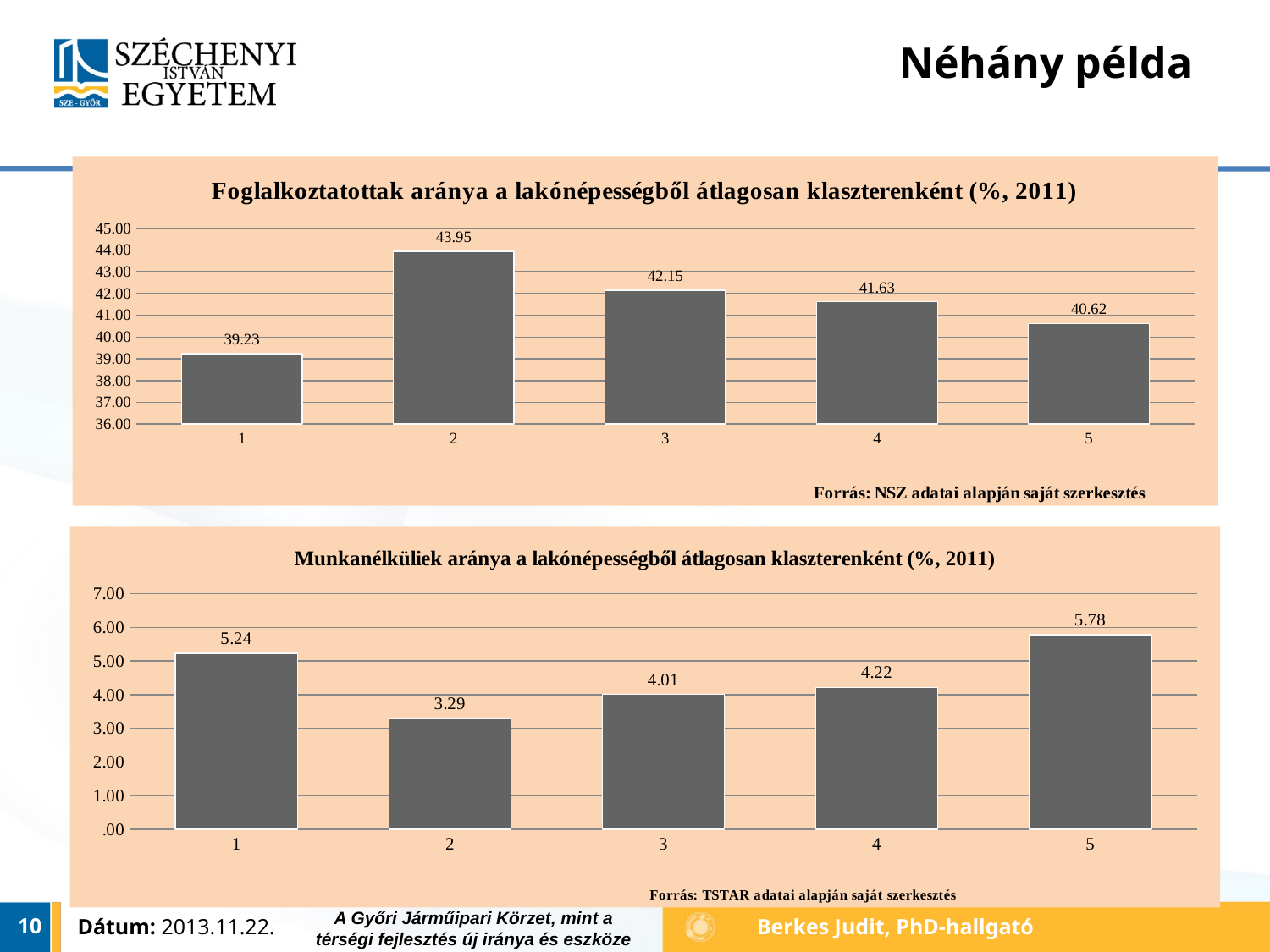
In the top chart (Foglalkoztatottak aránya), which is larger, the value for cluster 3 or cluster 4? cluster 3 In the bottom chart (Munkanélküliek aránya), what is the difference between the values for cluster 1 and cluster 2? 1.95 In the top chart (Foglalkoztatottak aránya), how many clusters are plotted? 5 In the top chart (Foglalkoztatottak aránya), which cluster has the lowest value? 1 In the bottom chart (Munkanélküliek aránya), what is the value for cluster 5? 5.78 In the top chart (Foglalkoztatottak aránya), is the value for cluster 5 greater or less than 40.00? greater What type of chart is the bottom chart (Munkanélküliek aránya)? bar chart In the top chart (Foglalkoztatottak aránya), what is the difference between the values for cluster 2 and cluster 1? 4.72 In the bottom chart (Munkanélküliek aránya), do the values rise or fall from cluster 2 to cluster 5? rise In the top chart (Foglalkoztatottak aránya), what is the value for cluster 2? 43.95 In the bottom chart (Munkanélküliek aránya), which cluster has the highest value? 5 In the bottom chart (Munkanélküliek aránya), which cluster has the lowest value? 2